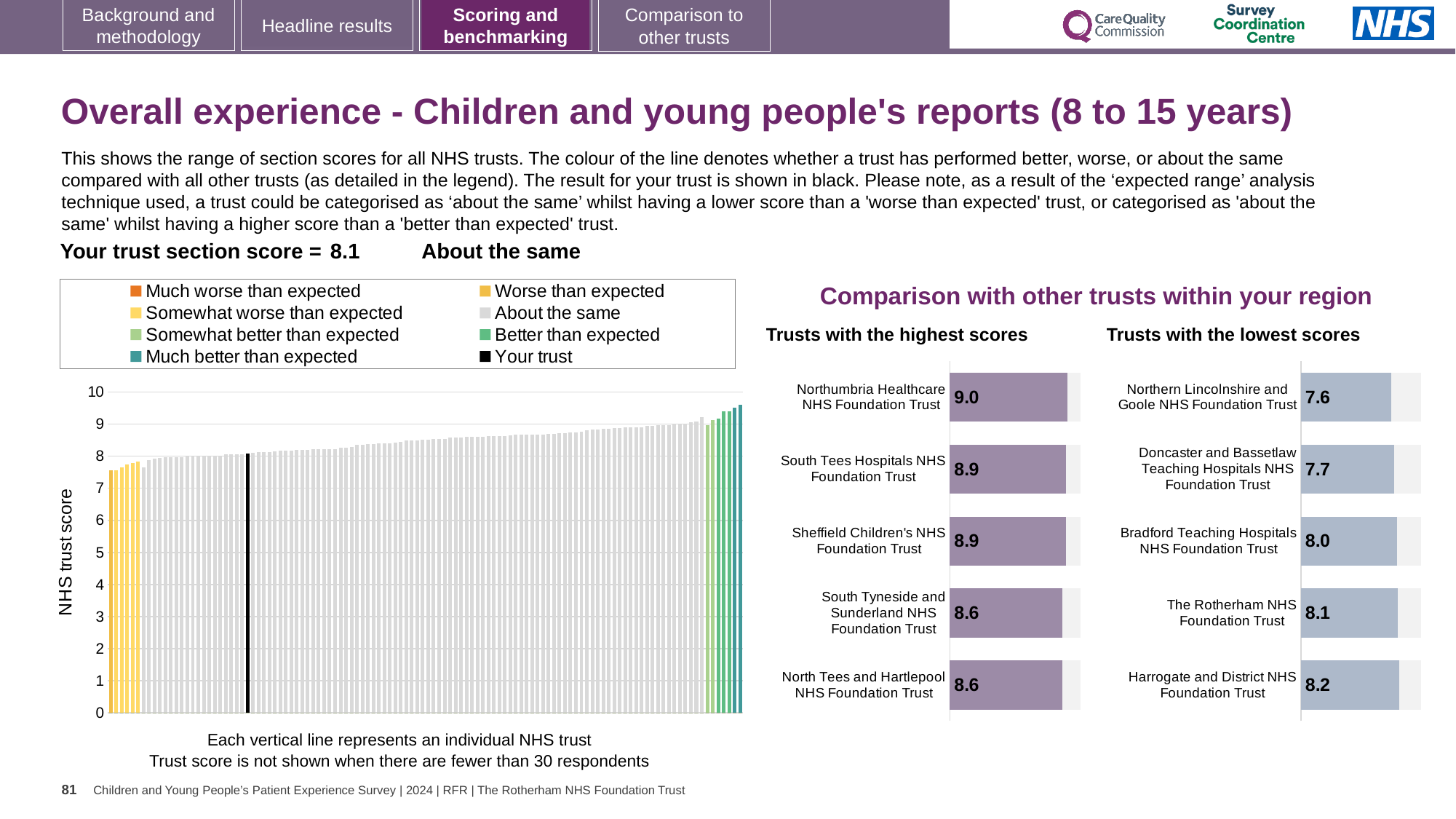
In the 'Trusts with the lowest scores' chart, which has the larger score: Bradford Teaching Hospitals NHS Foundation Trust or Harrogate and District NHS Foundation Trust? Harrogate and District NHS Foundation Trust In the 'Trusts with the highest scores' chart, what is the difference between the scores of Northumbria Healthcare NHS Foundation Trust and North Tees and Hartlepool NHS Foundation Trust? 0.4 In the 'Trusts with the highest scores' chart, what is the score for Northumbria Healthcare NHS Foundation Trust? 9.0 In the 'Trusts with the lowest scores' chart, what is the score for Northern Lincolnshire and Goole NHS Foundation Trust? 7.6 In the 'NHS trust score' chart on the left, do the bar heights rise or fall from left to right? Rise In the 'Trusts with the lowest scores' chart, what is the score for The Rotherham NHS Foundation Trust? 8.1 How many trusts are listed in the 'Trusts with the highest scores' chart? 5 In the 'NHS trust score' chart on the left, is the value of the tallest bar greater or less than 9? greater What kind of chart is the 'NHS trust score' chart on the left of the slide? Bar chart In the 'Trusts with the lowest scores' chart, which trust has the lowest score? Northern Lincolnshire and Goole NHS Foundation Trust How many entries does the legend above the 'NHS trust score' chart list? 8 In the 'Trusts with the highest scores' chart, which trust has the highest score? Northumbria Healthcare NHS Foundation Trust